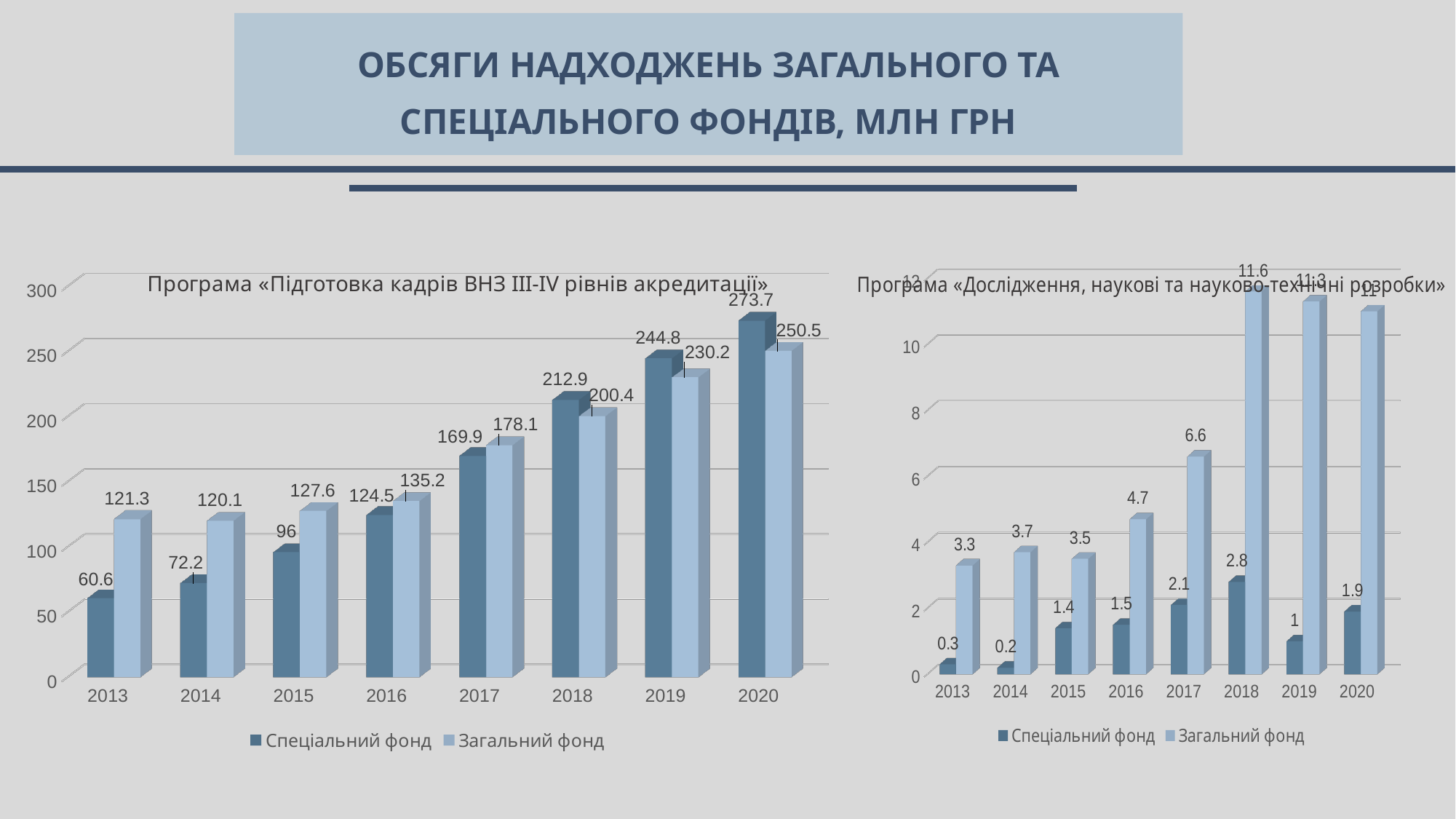
In the right chart (Програма «Дослідження, наукові та науково-технічні розробки»), what is the value of Спеціальний фонд in 2019? 1 In the left chart (Програма «Підготовка кадрів ВНЗ III-IV рівнів акредитації»), what is the difference between Спеціальний фонд and Загальний фонд in 2020? 23.2 In the right chart (Програма «Дослідження, наукові та науково-технічні розробки»), what is the difference between Загальний фонд and Спеціальний фонд in 2017? 4.5 In the left chart (Програма «Підготовка кадрів ВНЗ III-IV рівнів акредитації»), does the Спеціальний фонд value rise or fall from 2013 to 2020? rise In the left chart (Програма «Підготовка кадрів ВНЗ III-IV рівнів акредитації»), what is the value of Спеціальний фонд in 2017? 169.9 In the left chart (Програма «Підготовка кадрів ВНЗ III-IV рівнів акредитації»), which year has the lowest Загальний фонд value? 2014 In the left chart (Програма «Підготовка кадрів ВНЗ III-IV рівнів акредитації»), what is the value of Загальний фонд in 2014? 120.1 In the right chart (Програма «Дослідження, наукові та науково-технічні розробки»), what is the value of Загальний фонд in 2018? 11.6 In the right chart (Програма «Дослідження, наукові та науково-технічні розробки»), which year has the lowest Спеціальний фонд value? 2014 How many years are shown on the x axis of the right chart (Програма «Дослідження, наукові та науково-технічні розробки»)? 8 In the left chart (Програма «Підготовка кадрів ВНЗ III-IV рівнів акредитації»), which is larger in 2016: Спеціальний фонд or Загальний фонд? Загальний фонд In the left chart (Програма «Підготовка кадрів ВНЗ III-IV рівнів акредитації»), which year has the highest Спеціальний фонд value? 2020